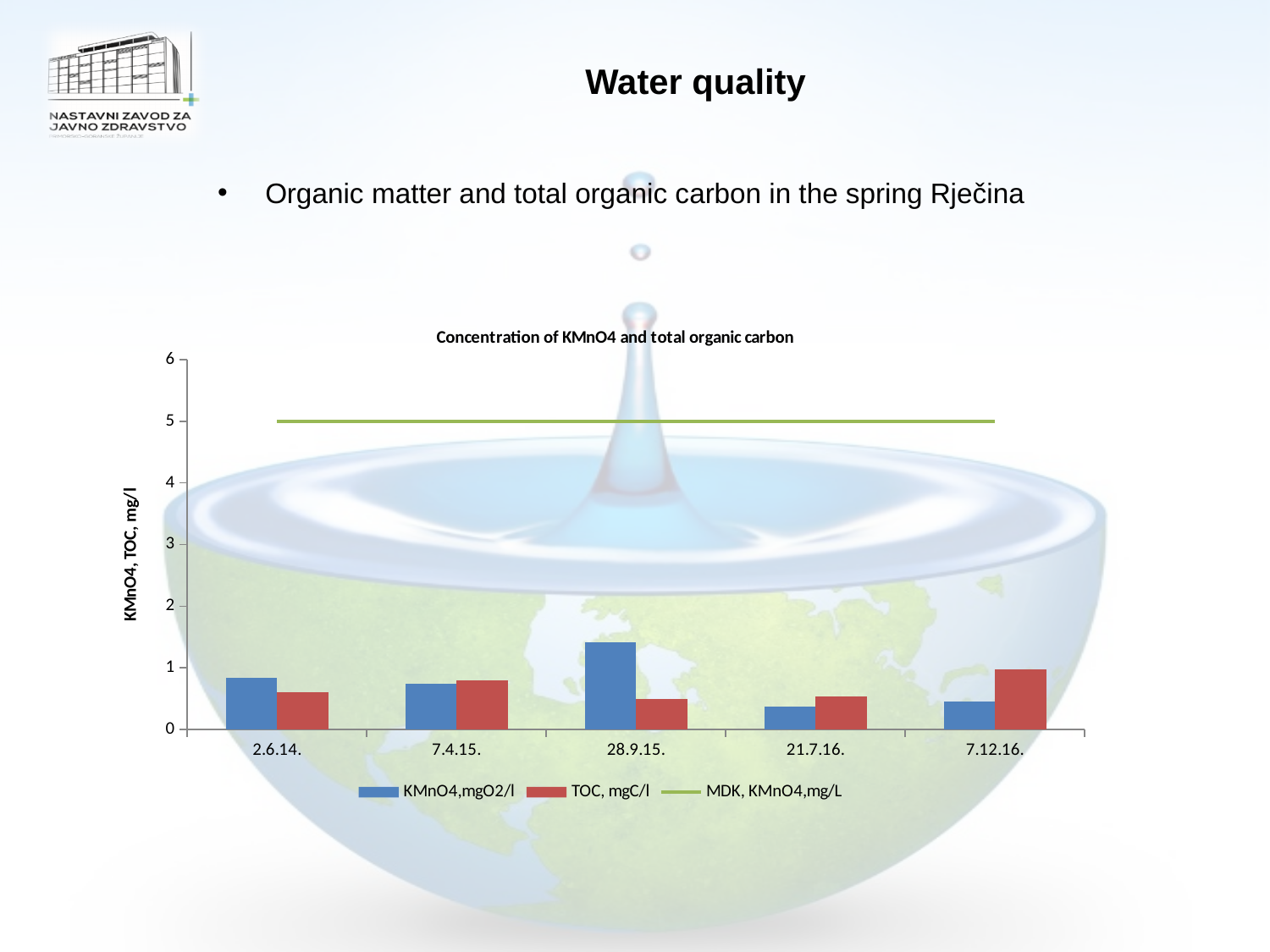
What is the label of the vertical axis? KMnO4, TOC, mg/l On which date is the KMnO4,mgO2/l value highest? 28.9.15. What kind of chart is shown on the slide? combination bar and line chart Is the KMnO4,mgO2/l value for 28.9.15. greater or less than 1? greater How many sampling dates are shown on the x axis of the chart? 5 On 7.12.16., which is larger: KMnO4,mgO2/l or TOC, mgC/l? TOC, mgC/l On which date is the KMnO4,mgO2/l value lowest? 21.7.16. Is the KMnO4,mgO2/l value for 2.6.14. greater or less than 1? less On which date is the TOC, mgC/l value highest? 7.12.16. How many series does the chart legend list? 3 What is the title of the chart? Concentration of KMnO4 and total organic carbon At what value does the MDK, KMnO4,mg/L line sit on the chart? 5